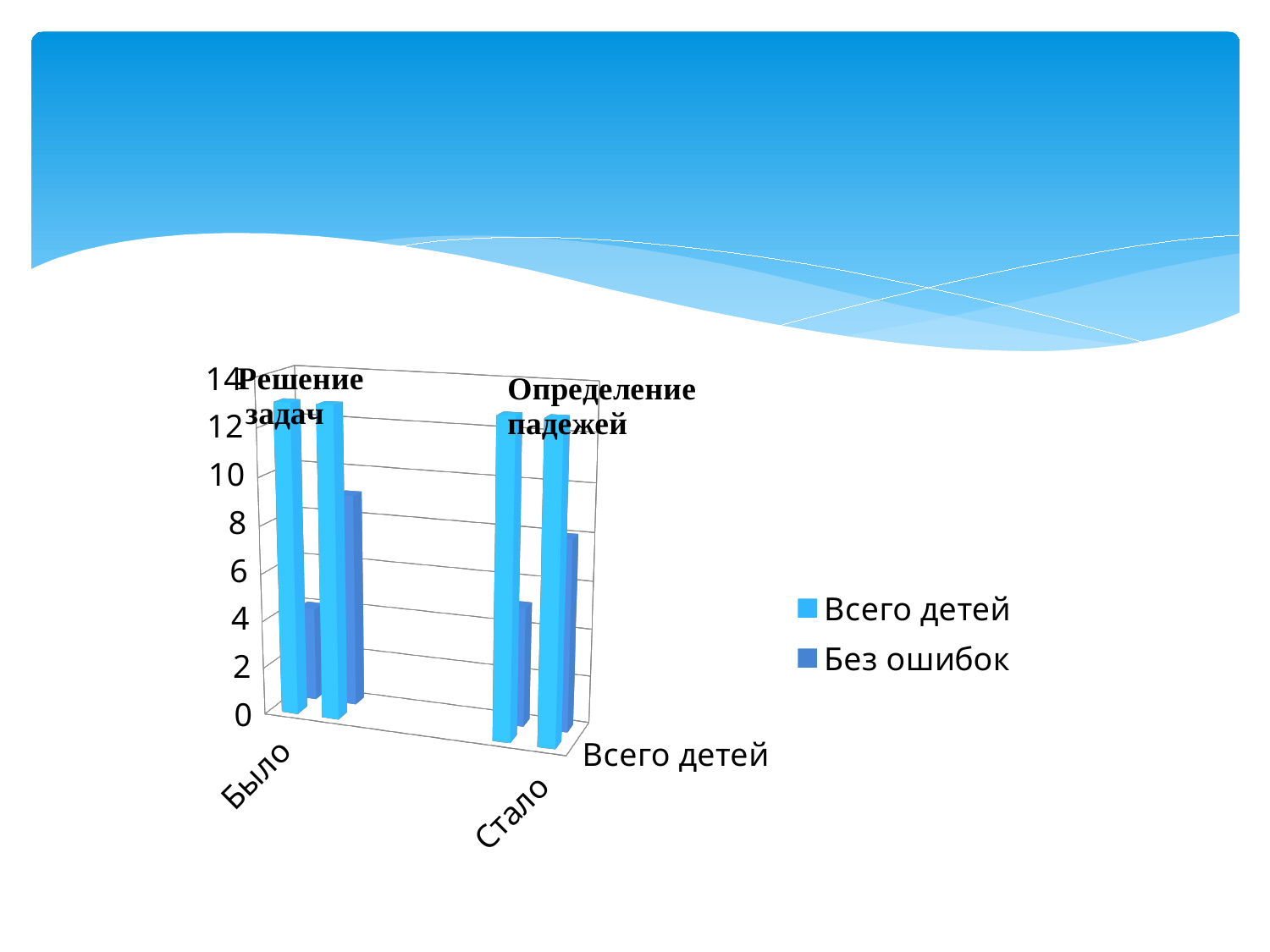
What are the two series named in the legend? Всего детей, Без ошибок What kind of chart is shown on the slide? bar chart What is the highest value shown on the vertical axis? 14 Which series has the taller bars, Всего детей or Без ошибок? Всего детей How many series does the legend list? 2 How many category labels are shown on the x axis? 2 Are the Всего детей bars greater or less than 10? greater Is the leftmost Без ошибок bar under Стало greater or less than 6? less What are the category labels on the x axis? Было, Стало Is the leftmost Без ошибок bar under Было greater or less than 6? less